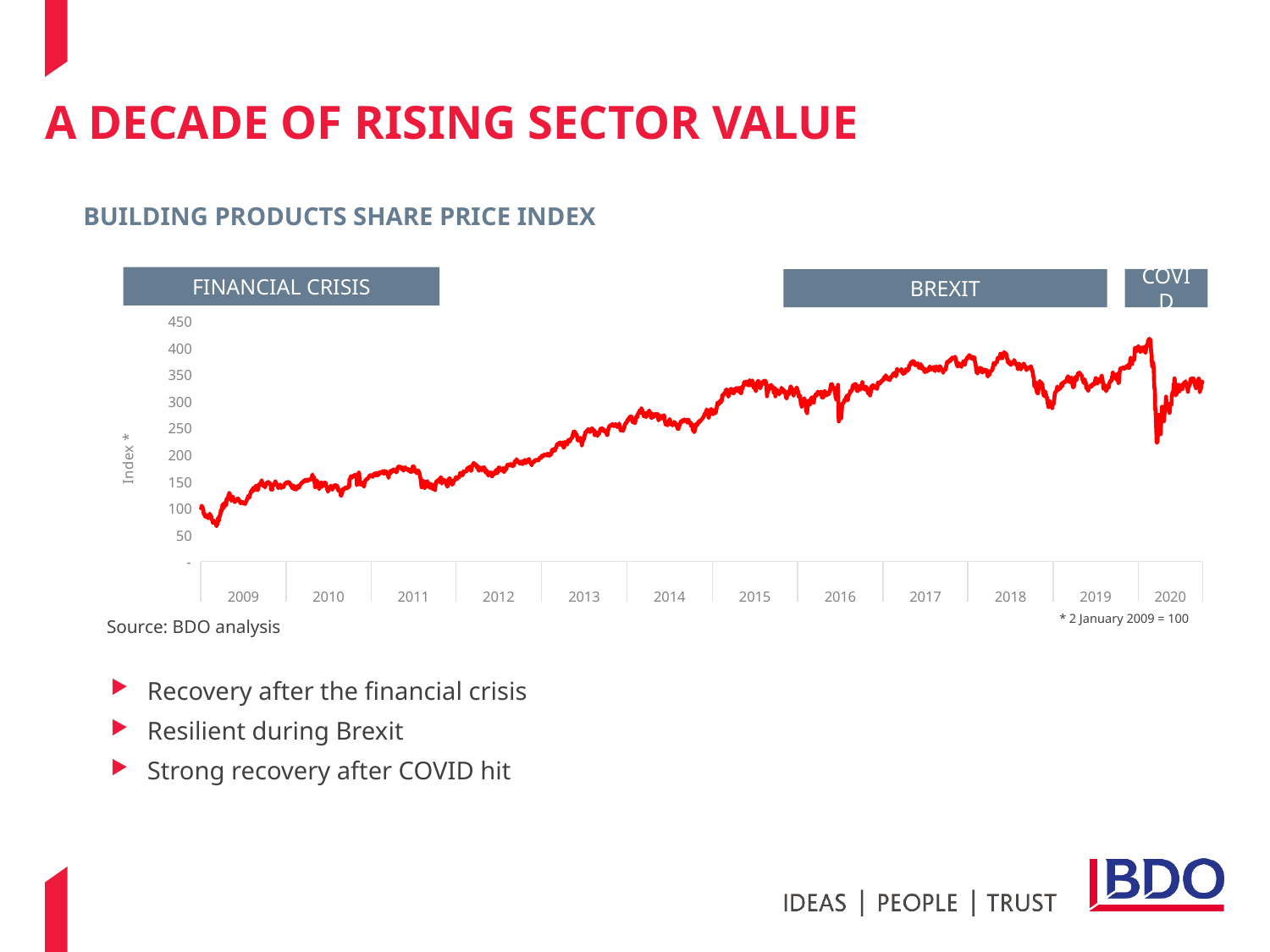
What index value does 2 January 2009 correspond to, according to the footnote? 100 Overall, does the index rise or fall from 2009 to 2020? rise Is the index value during 2017 greater or less than 300? greater What is the title of the chart? Building Products Share Price Index What are the three events annotated above the chart? Financial Crisis, Brexit, COVID How many years are labelled on the x axis? 12 Is the index value during 2012 greater or less than 250? less What kind of chart is shown on the slide? line chart In which year does the index reach its lowest point? 2009 Is the index value during 2010 greater or less than 200? less Which year has the higher index value, 2010 or 2017? 2017